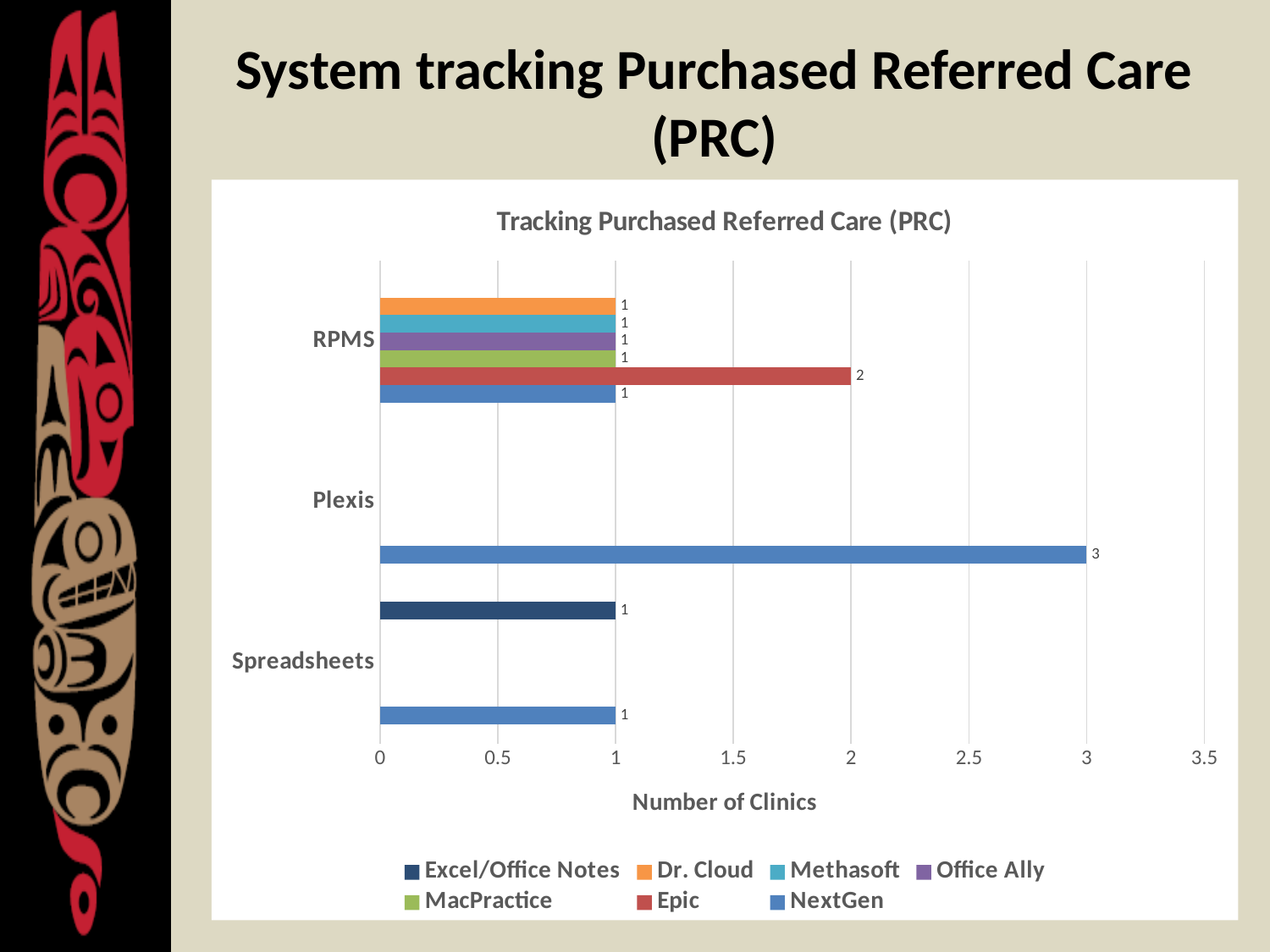
Which series has the highest value in the RPMS category? Epic What is the title of the chart? Tracking Purchased Referred Care (PRC) What is the difference between the NextGen value for Plexis and the NextGen value for RPMS? 2 Which is larger: the Epic value for RPMS or the NextGen value for Plexis? NextGen value for Plexis How many categories are shown on the vertical axis of the chart? 3 How many series does the chart legend list? 7 What is the label of the horizontal axis? Number of Clinics What type of chart is shown on the slide? bar chart What is the value for NextGen in the Plexis category? 3 What is the value for Epic in the RPMS category? 2 What is the value for NextGen in the Spreadsheets category? 1 What is the value for Excel/Office Notes in the Spreadsheets category? 1